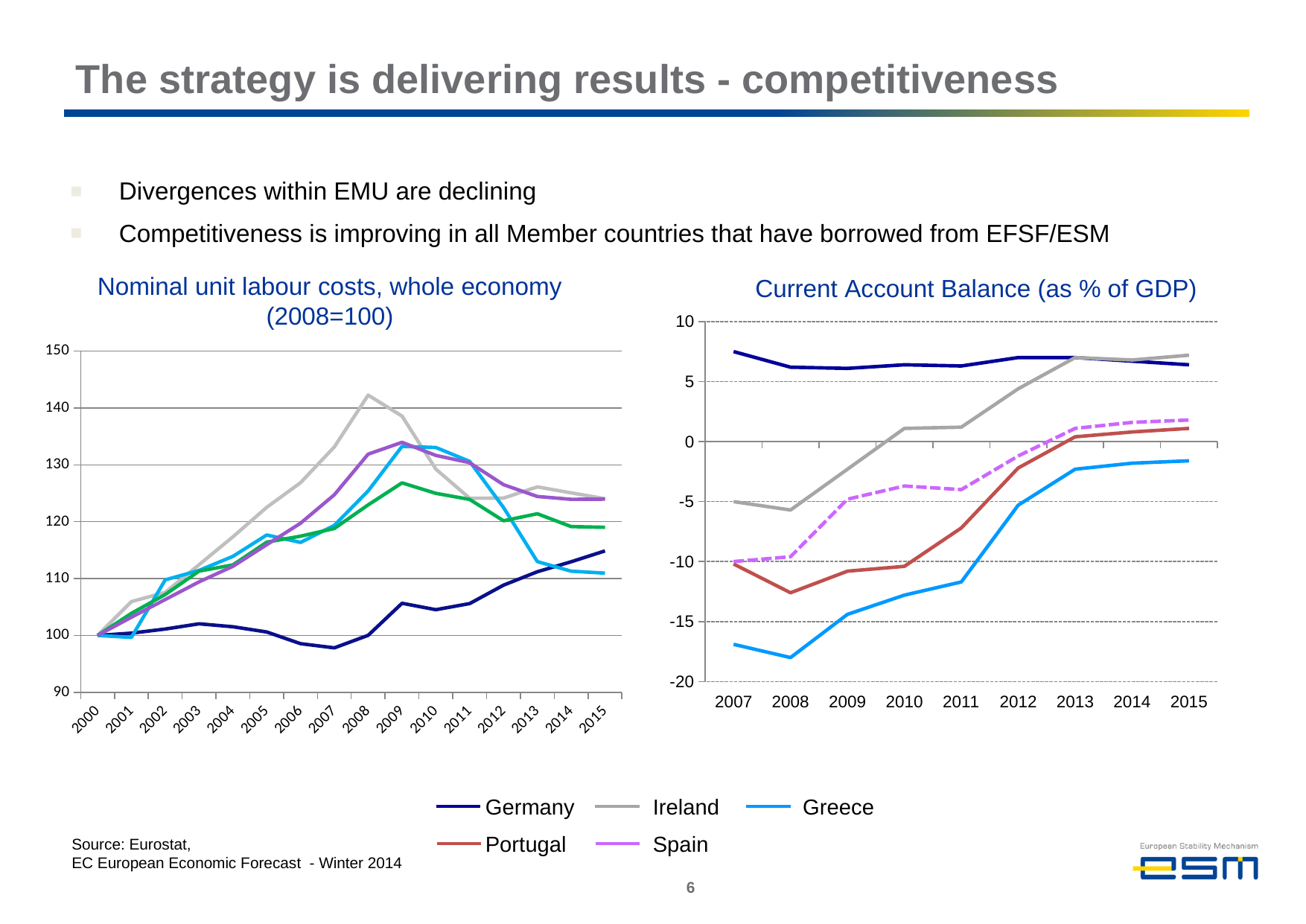
In the 'Current Account Balance (as % of GDP)' chart, is the value for Greece in 2008 greater or less than -15? less How many years are shown on the x axis of the 'Current Account Balance (as % of GDP)' chart? 9 In the 'Nominal unit labour costs' chart, is the value for Ireland in 2008 greater or less than 140? greater In the 'Nominal unit labour costs' chart, is the value for Germany in 2007 greater or less than 100? less In the 'Current Account Balance (as % of GDP)' chart, which is larger in 2011, Portugal or Greece? Portugal In the 'Current Account Balance (as % of GDP)' chart, which country has the lowest value in 2007? Greece In the 'Nominal unit labour costs' chart, which country has the lowest value in 2008? Germany How many series does the shared legend list? 5 In the 'Current Account Balance (as % of GDP)' chart, does the value for Greece rise or fall from 2008 to 2015? rise How many years are shown on the x axis of the 'Nominal unit labour costs' chart? 16 What kind of chart is the 'Nominal unit labour costs, whole economy (2008=100)' chart? line chart In the 'Nominal unit labour costs' chart, which country has the highest value in 2008? Ireland